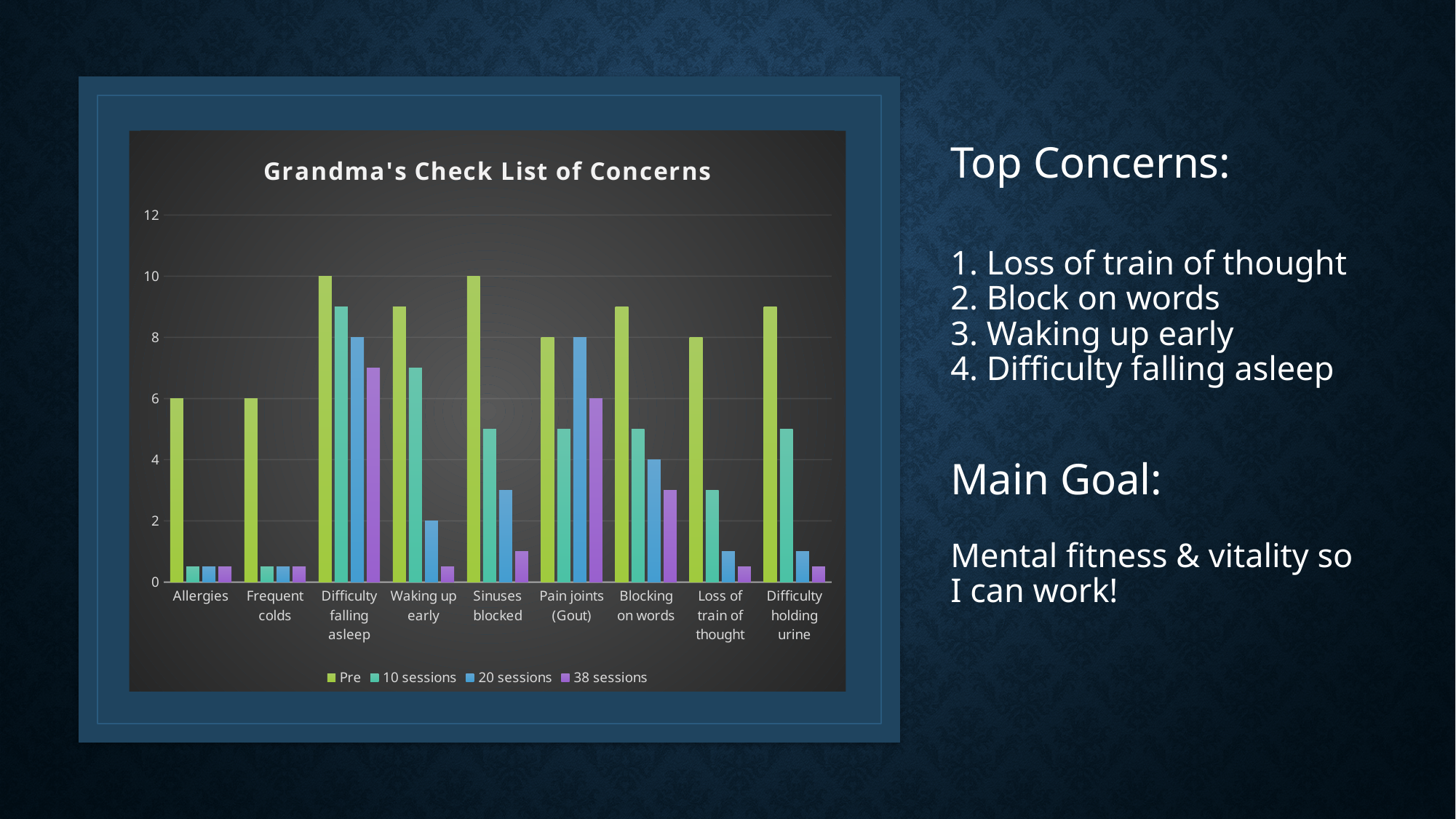
How many series does the chart legend list? 4 Which series is shown in purple in the legend? 38 sessions What type of chart is shown on the slide? bar chart What is the 20 sessions value for Pain joints (Gout)? 8 Is the 10 sessions value for Loss of train of thought greater or less than 4? less What is the title of the chart? Grandma's Check List of Concerns Which is larger for Waking up early: the Pre value or the 38 sessions value? Pre Is the 38 sessions value for Difficulty falling asleep greater or less than 6? greater What is the Pre value for Difficulty falling asleep? 10 What is the Pre value for Sinuses blocked? 10 What is the Pre value for Allergies? 6 How many concern categories are shown along the x axis? 9